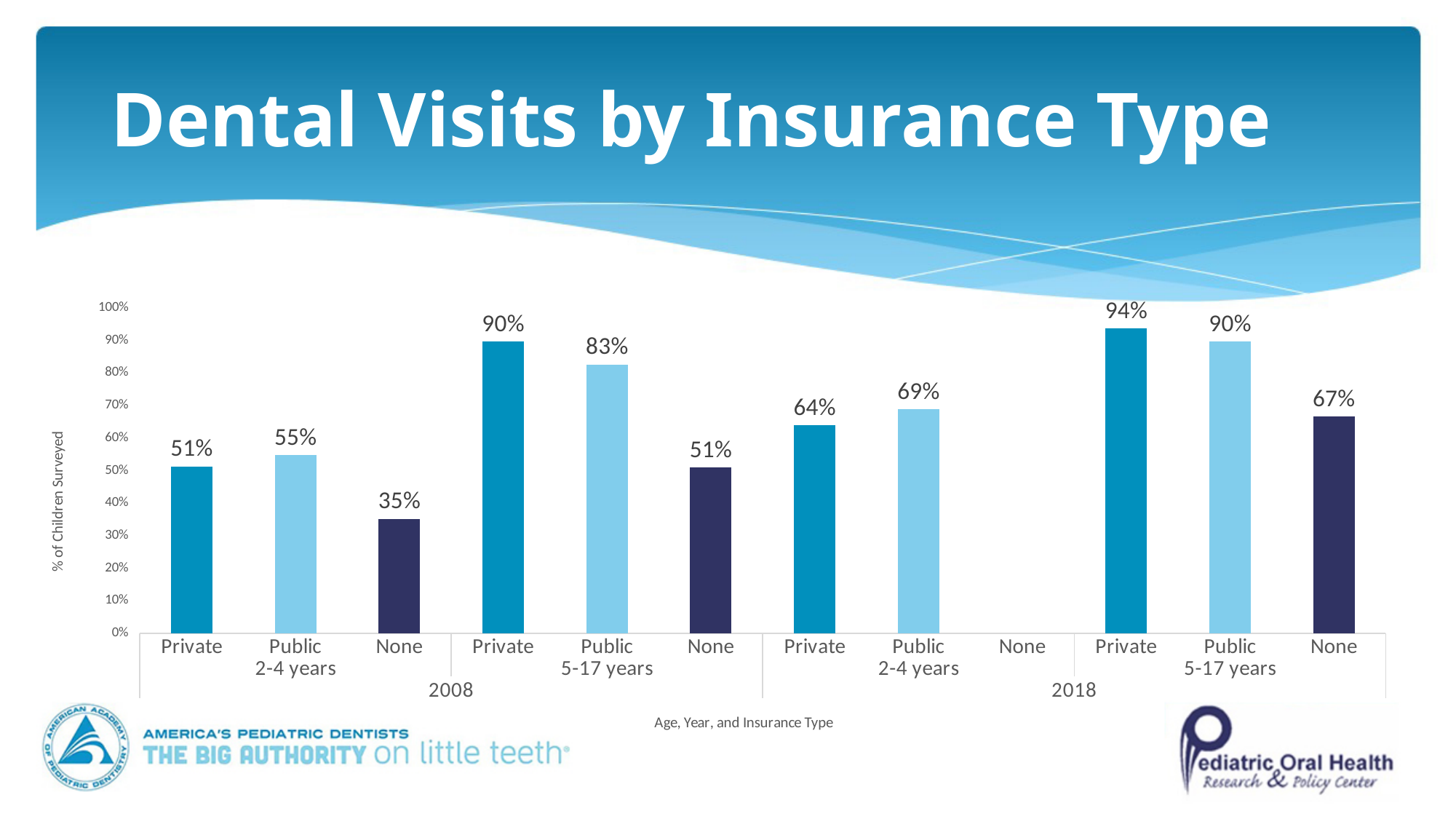
What is the value for Private insurance, 2-4 years, in 2008? 51% What is the difference between the Public and None values for 5-17 years in 2008? 32% What is the value for None (no insurance), 5-17 years, in 2018? 67% Which is larger for 2-4 years in 2008: Private or Public? Public What kind of chart is shown on the slide? Bar chart What is the value for Public insurance, 2-4 years, in 2018? 69% What is the label of the vertical axis? % of Children Surveyed What is the difference between the Private 5-17 years value in 2018 and in 2008? 4% Does the Private 2-4 years value rise or fall from 2008 to 2018? Rise Which bar has the lowest value on the chart? None, 2-4 years, 2008 (35%) Which bar has the highest value on the chart? Private, 5-17 years, 2018 (94%) Is the value for None, 5-17 years, in 2008 greater or less than 60%? less